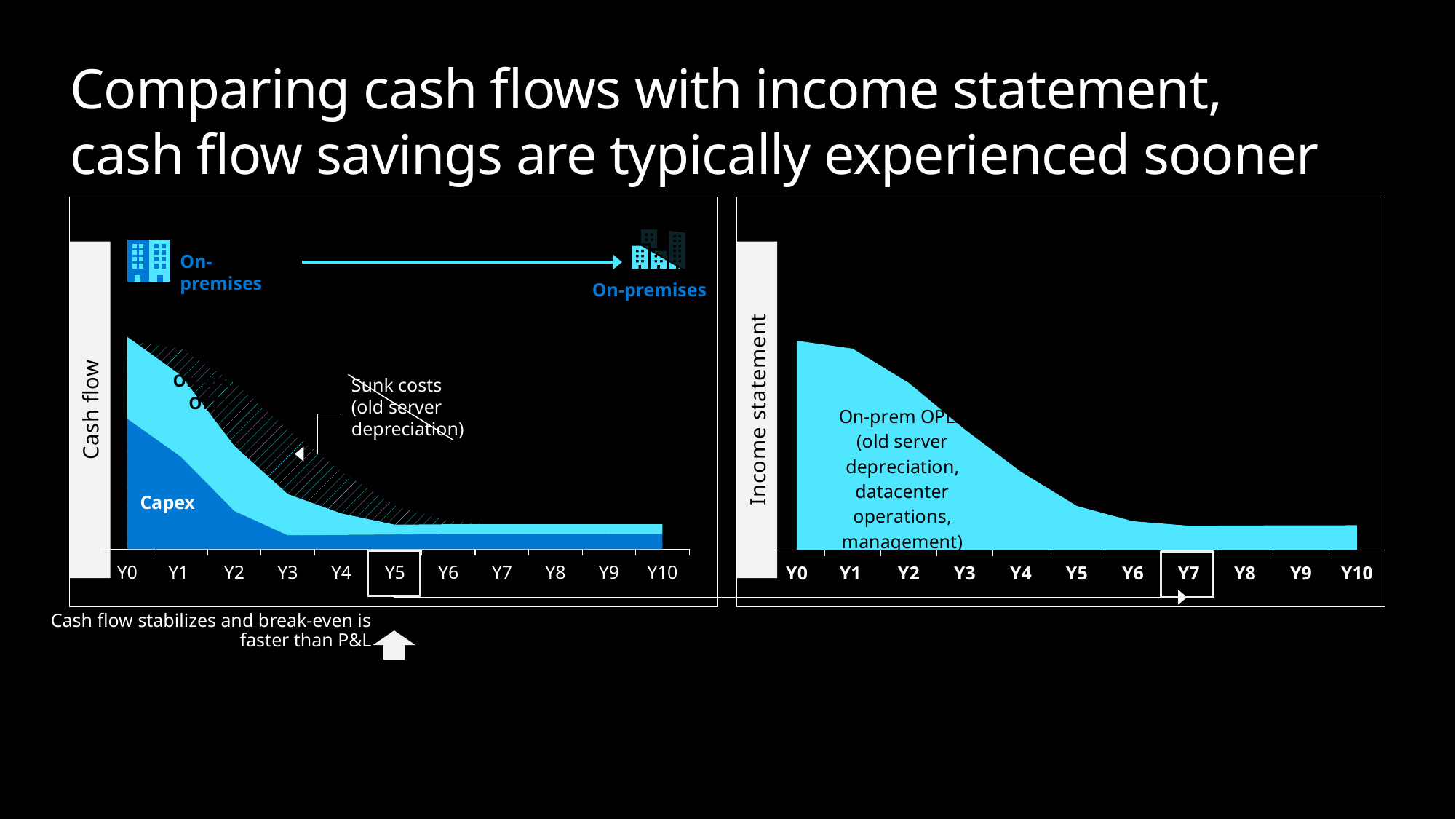
How many year categories are shown on the x axis of the left "Cash flow" chart? 11 In the left "Cash flow" chart, is the total value at Y0 larger or smaller than the total value at Y10? Larger What kind of chart is the right chart labelled "Income statement"? Area chart In the left "Cash flow" chart, which year is highlighted with a box on the x axis? Y5 In the right "Income statement" chart, is the value at Y2 larger or smaller than the value at Y8? Larger How many year categories are shown on the x axis of the right "Income statement" chart? 11 What kind of chart is the left chart labelled "Cash flow"? Area chart In the right "Income statement" chart, do the plotted values rise or fall from Y0 to Y7? Fall In the right "Income statement" chart, which year is highlighted with a box on the x axis? Y7 In the left "Cash flow" chart, do the plotted values rise or fall from Y0 to Y5? Fall